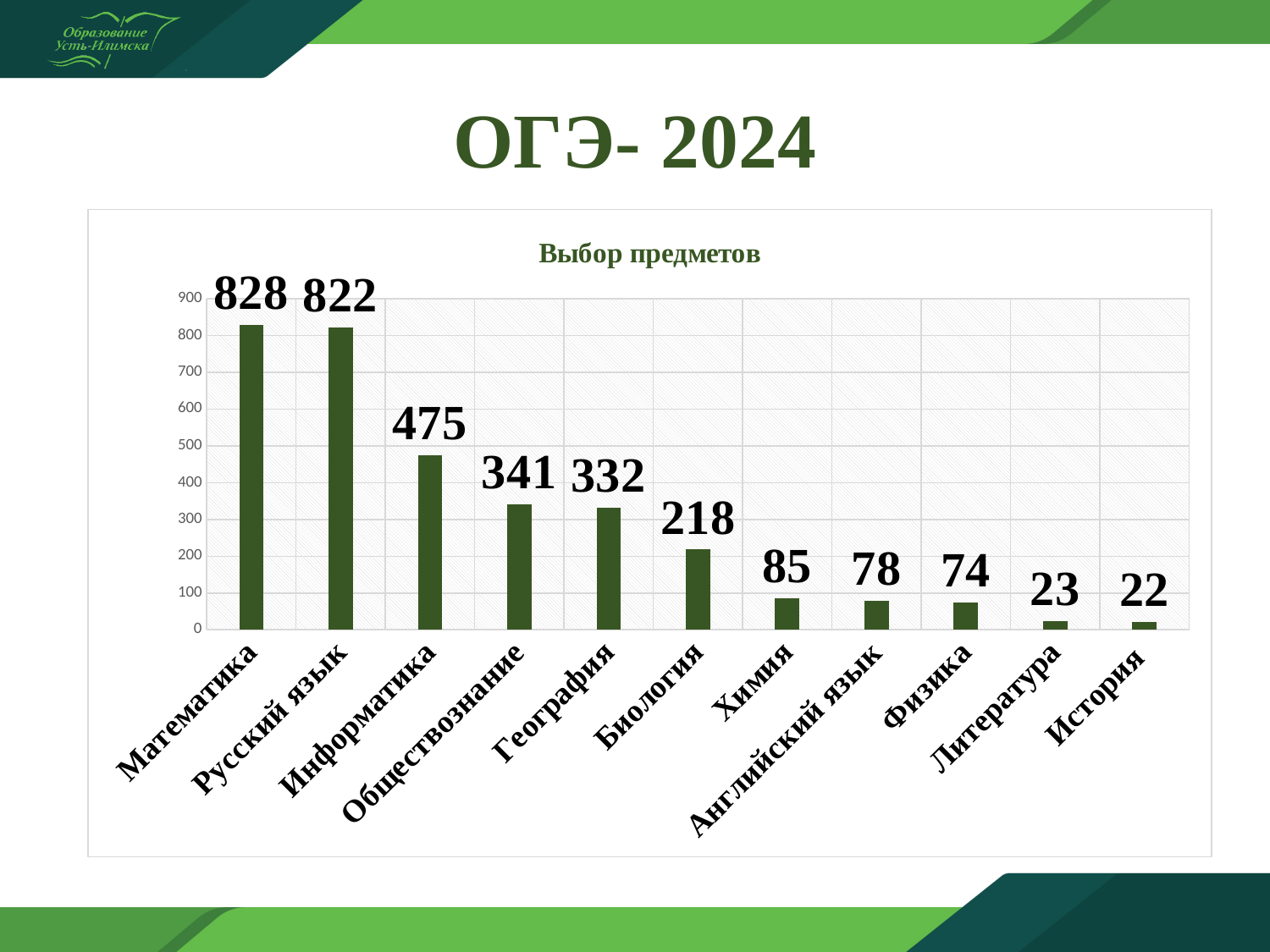
Is the value for Информатика greater or less than 400? greater What is the value for Физика? 74 What is the value for Биология? 218 What kind of chart is shown on the slide? bar chart Which subject has the lowest value? История What is the title of the chart? Выбор предметов How many subjects are shown in the chart? 11 What is the difference between the values for Обществознание and География? 9 Which is larger, the value for Химия or the value for Английский язык? Химия Which subject has the highest value? Математика What is the value for Информатика? 475 What is the difference between the values for Математика and Русский язык? 6